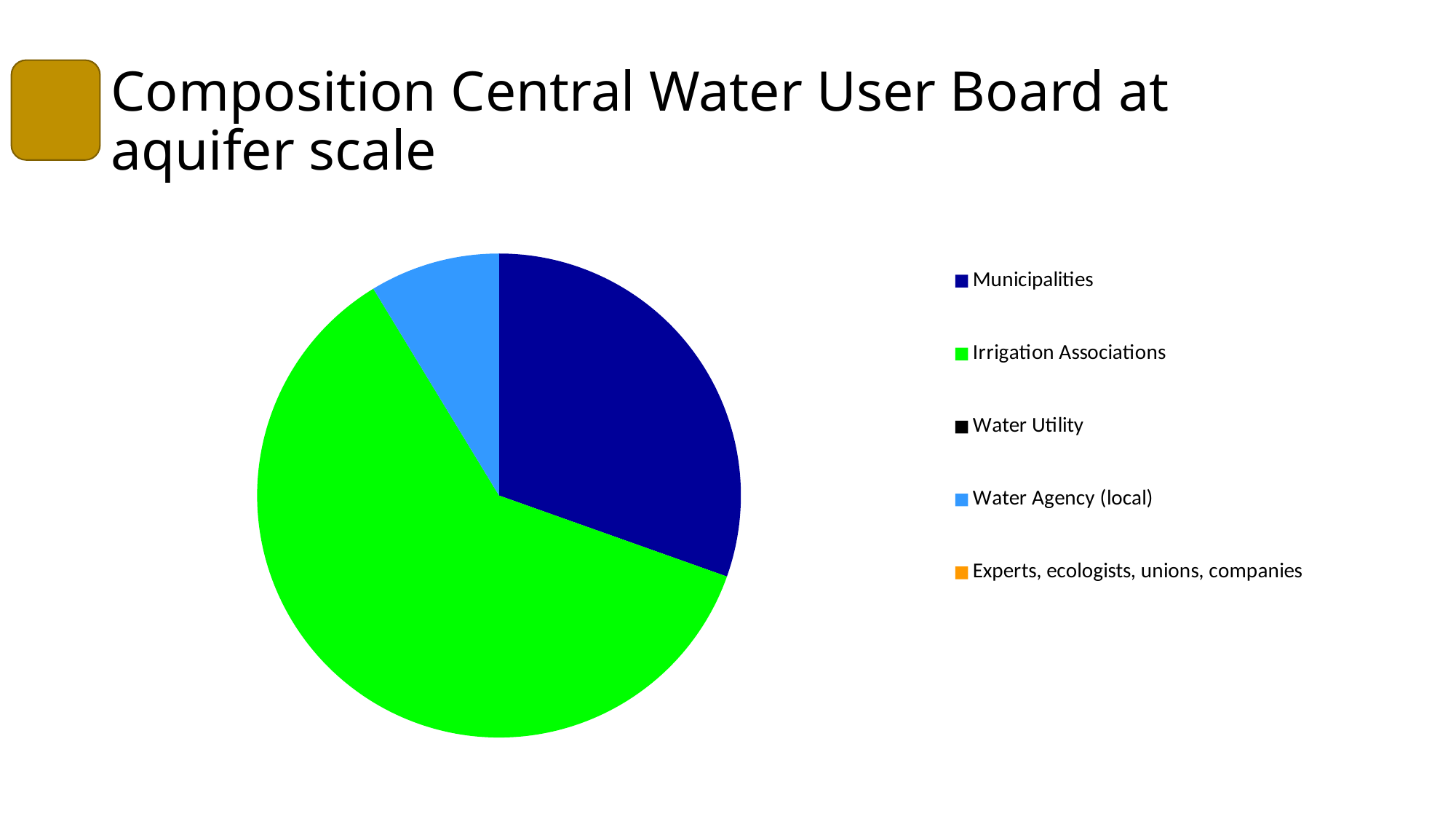
What colour is the slice for Irrigation Associations? green Which category has the largest slice of the pie? Irrigation Associations How many entries does the legend list? 5 Of the three visible slices, which category has the smallest one? Water Agency (local) What is the title of the slide containing the pie chart? Composition Central Water User Board at aquifer scale What kind of chart is shown on the slide? pie chart Which is larger, the slice for Water Agency (local) or the slice for Irrigation Associations? Irrigation Associations Which is larger, the slice for Municipalities or the slice for Water Agency (local)? Municipalities Which is larger, the slice for Irrigation Associations or the slice for Municipalities? Irrigation Associations